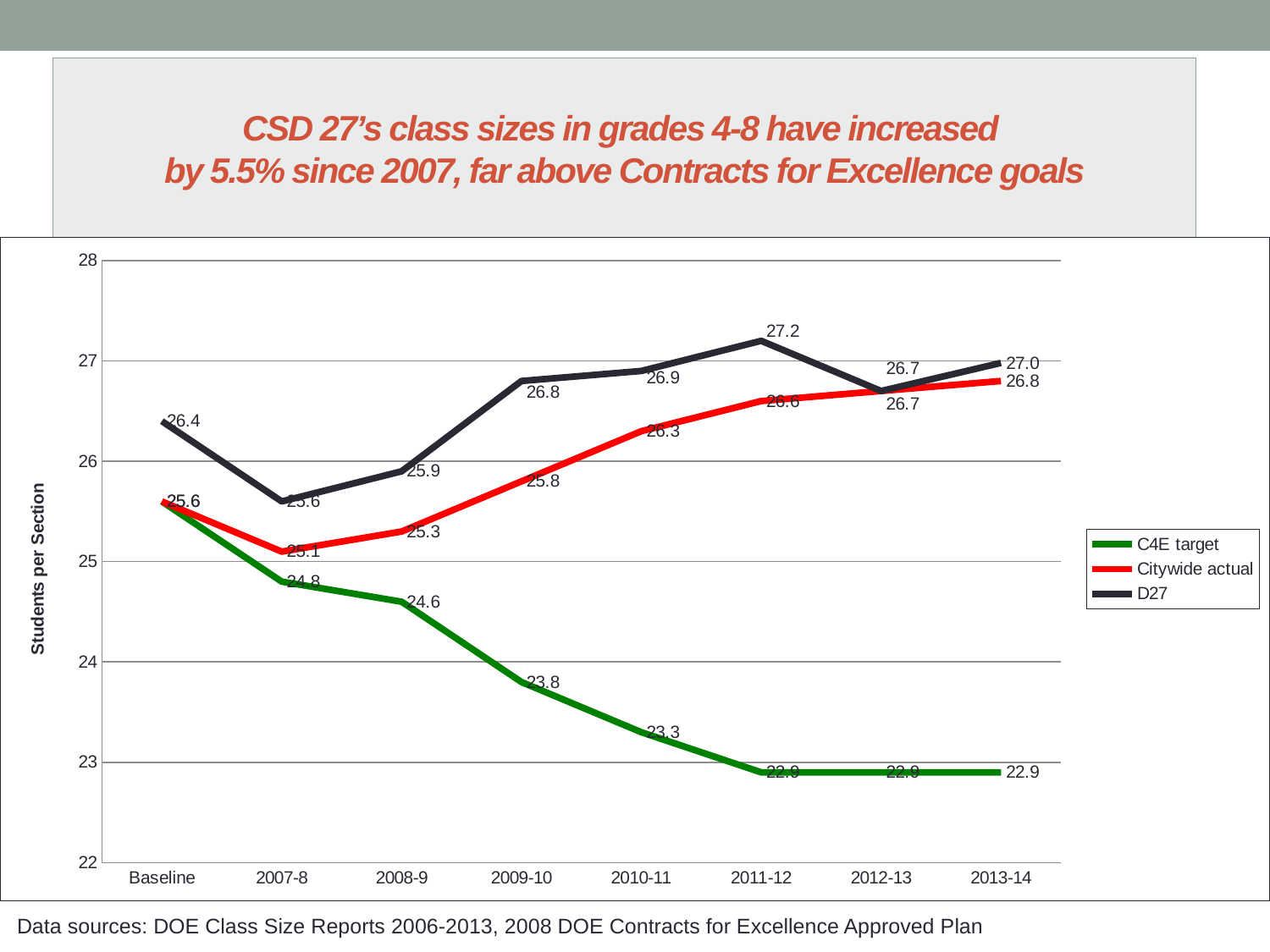
How many series does the legend list? 3 What is the label on the y axis? Students per Section What is the difference between the D27 and Citywide actual values in 2013-14? 0.2 What is the D27 value for 2011-12? 27.2 In which year is the D27 value highest? 2011-12 In which year is the D27 value lowest? 2007-8 In 2009-10, which is larger: the D27 value or the Citywide actual value? D27 What is the C4E target value for 2013-14? 22.9 What is the Citywide actual value for 2010-11? 26.3 What kind of chart is shown on the slide? Line chart How many points along the x axis does the chart have? 8 Does the C4E target line rise or fall from Baseline to 2013-14? Fall